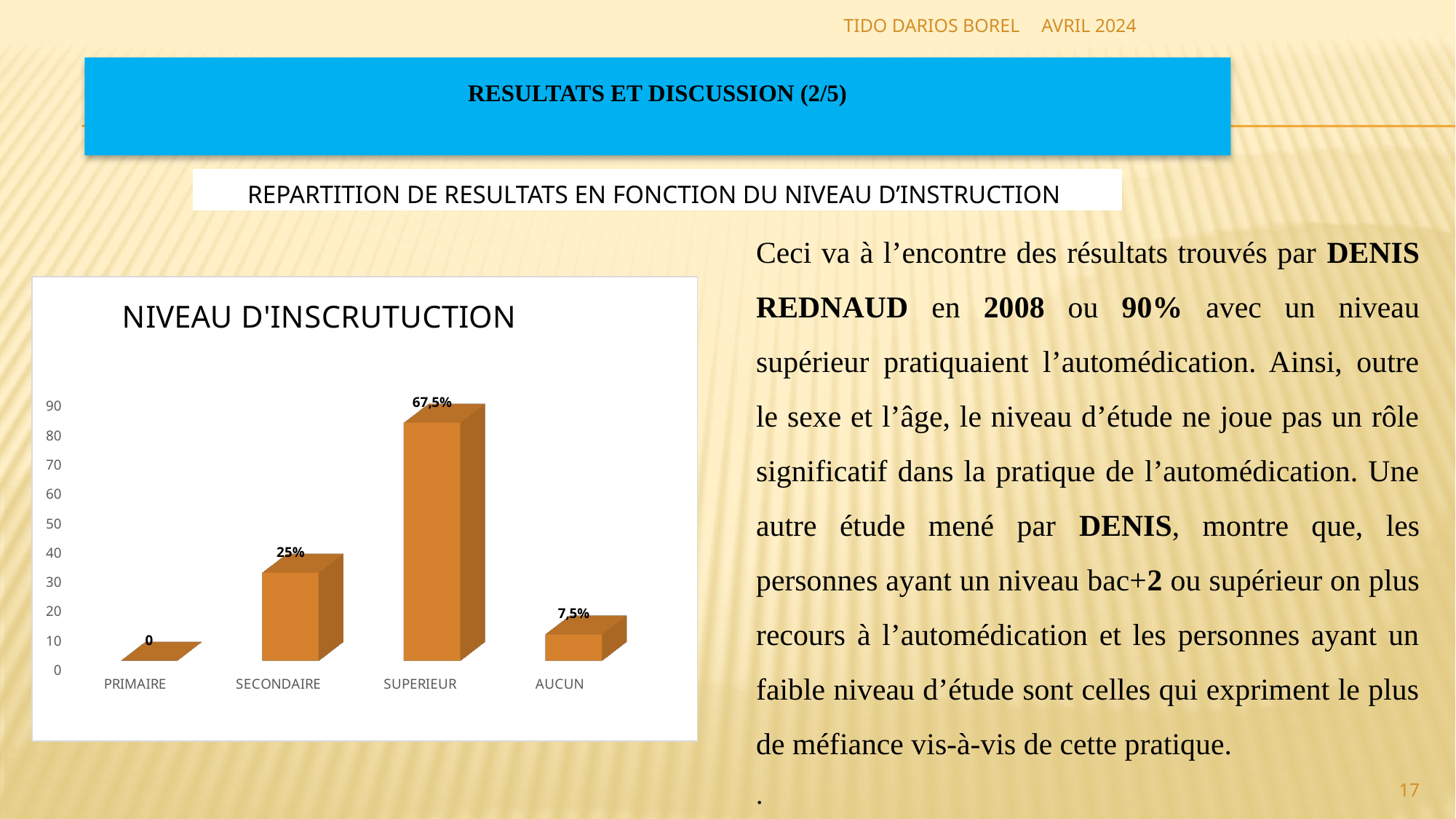
Which category has the lowest value in the chart? PRIMAIRE What is the difference between the values for SECONDAIRE and AUCUN? 17,5% Which category has the highest value in the chart? SUPERIEUR What is the value shown for SUPERIEUR in the NIVEAU D'INSCRUTUCTION chart? 67,5% What is the value shown for PRIMAIRE in the chart? 0 How many categories are shown on the x axis of the chart? 4 Which is larger, the value for SECONDAIRE or the value for AUCUN? SECONDAIRE What kind of chart is shown on the slide? Bar chart What is the title of the chart on the slide? NIVEAU D'INSCRUTUCTION What is the value shown for SECONDAIRE in the chart? 25% What is the difference between the values for SUPERIEUR and SECONDAIRE? 42,5% What is the value shown for AUCUN in the chart? 7,5%